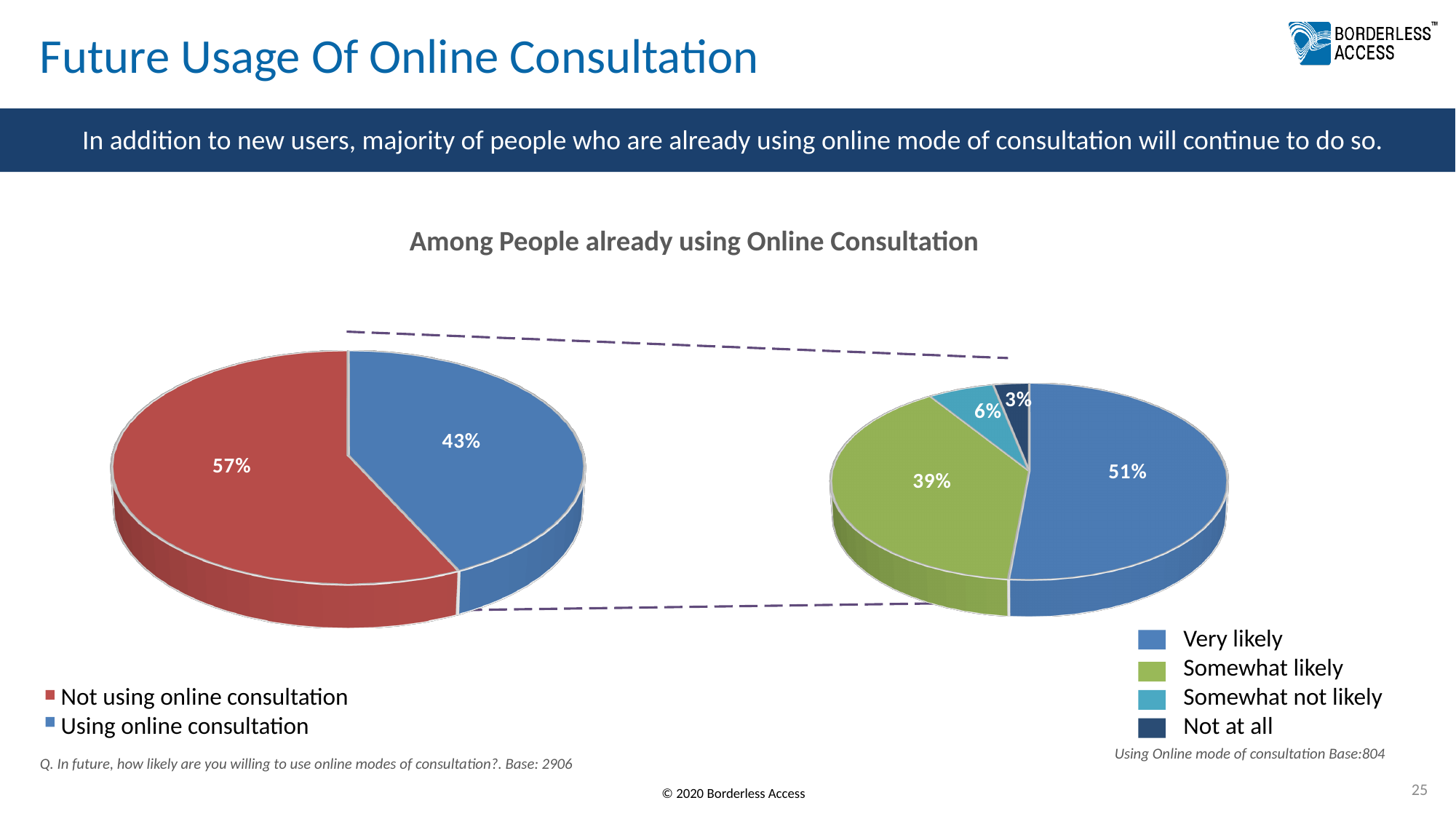
In the left pie chart, what share of people are not using online consultation? 57% In the right pie chart (Among People already using Online Consultation), which is larger: 'Very likely' or 'Somewhat likely'? Very likely In the right pie chart (Among People already using Online Consultation), what share is 'Somewhat not likely'? 6% In the right pie chart (Among People already using Online Consultation), what share is 'Somewhat likely'? 39% In the right pie chart (Among People already using Online Consultation), which category has the smallest slice? Not at all In the right pie chart (Among People already using Online Consultation), what is the difference between 'Very likely' and 'Somewhat likely'? 12% How many categories does the legend of the right pie chart (Among People already using Online Consultation) list? 4 In the left pie chart, what is the difference between the 'Not using online consultation' and 'Using online consultation' shares? 14% In the right pie chart (Among People already using Online Consultation), what share is 'Very likely'? 51% What type of chart is used on the left side of the slide? Pie chart In the left pie chart, what share of people are using online consultation? 43% In the left pie chart, which category has the larger slice? Not using online consultation